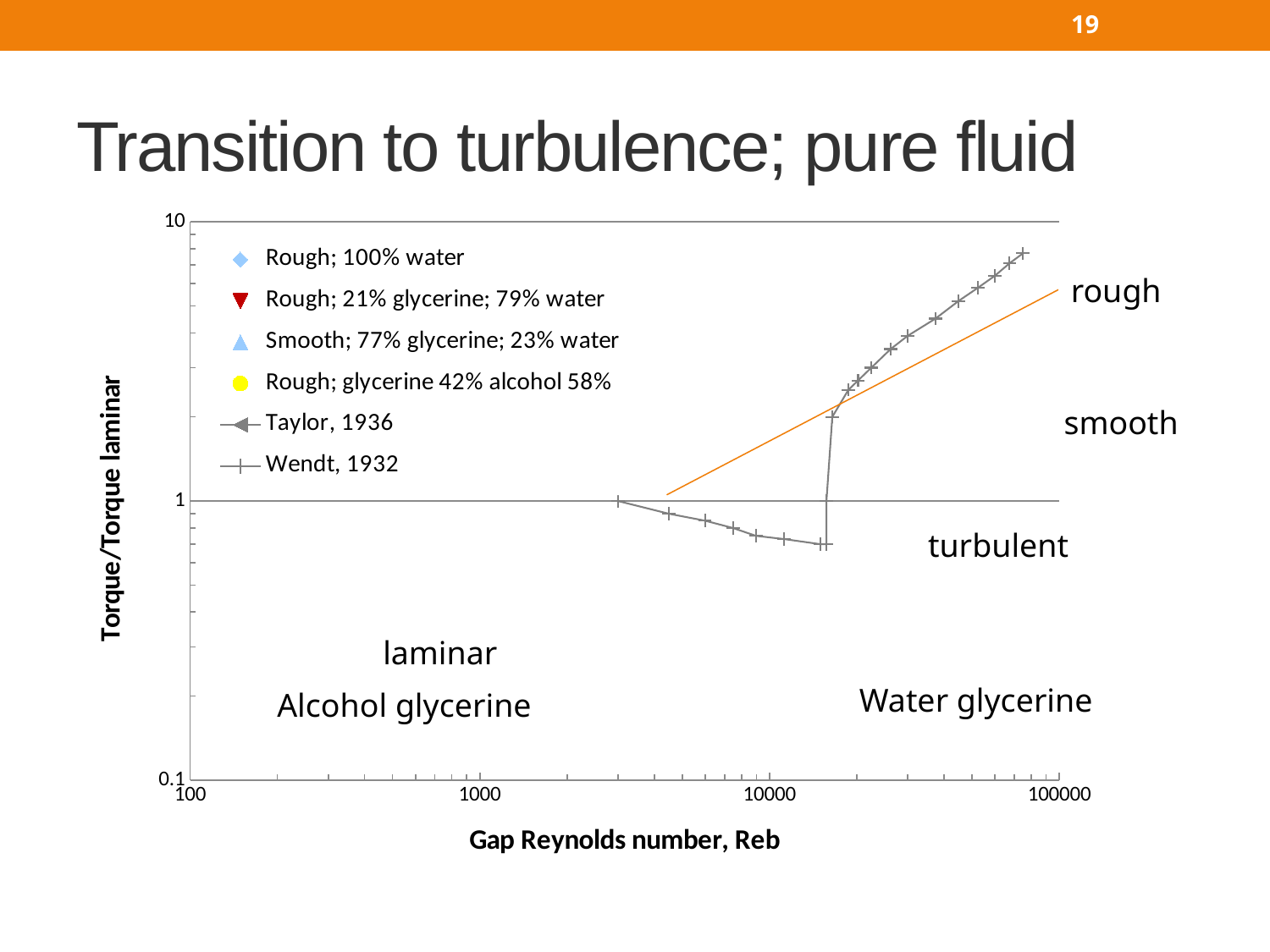
What is the highest value shown on the y axis? 10 Which legend entry is listed first in the chart? Rough; 100% water How many series does the chart legend list? 6 Does the Wendt, 1932 series rise or fall as the gap Reynolds number increases from about 3000 to about 15000? fall What is the label of the chart's y axis? Torque/Torque laminar Is the Wendt, 1932 value at its highest gap Reynolds number greater or less than 10? less Is the Wendt, 1932 value at a gap Reynolds number of about 10000 greater or less than 1? less Does the Wendt, 1932 series rise or fall as the gap Reynolds number increases beyond about 20000? rise Is the Wendt, 1932 value at its highest gap Reynolds number greater or less than 1? greater